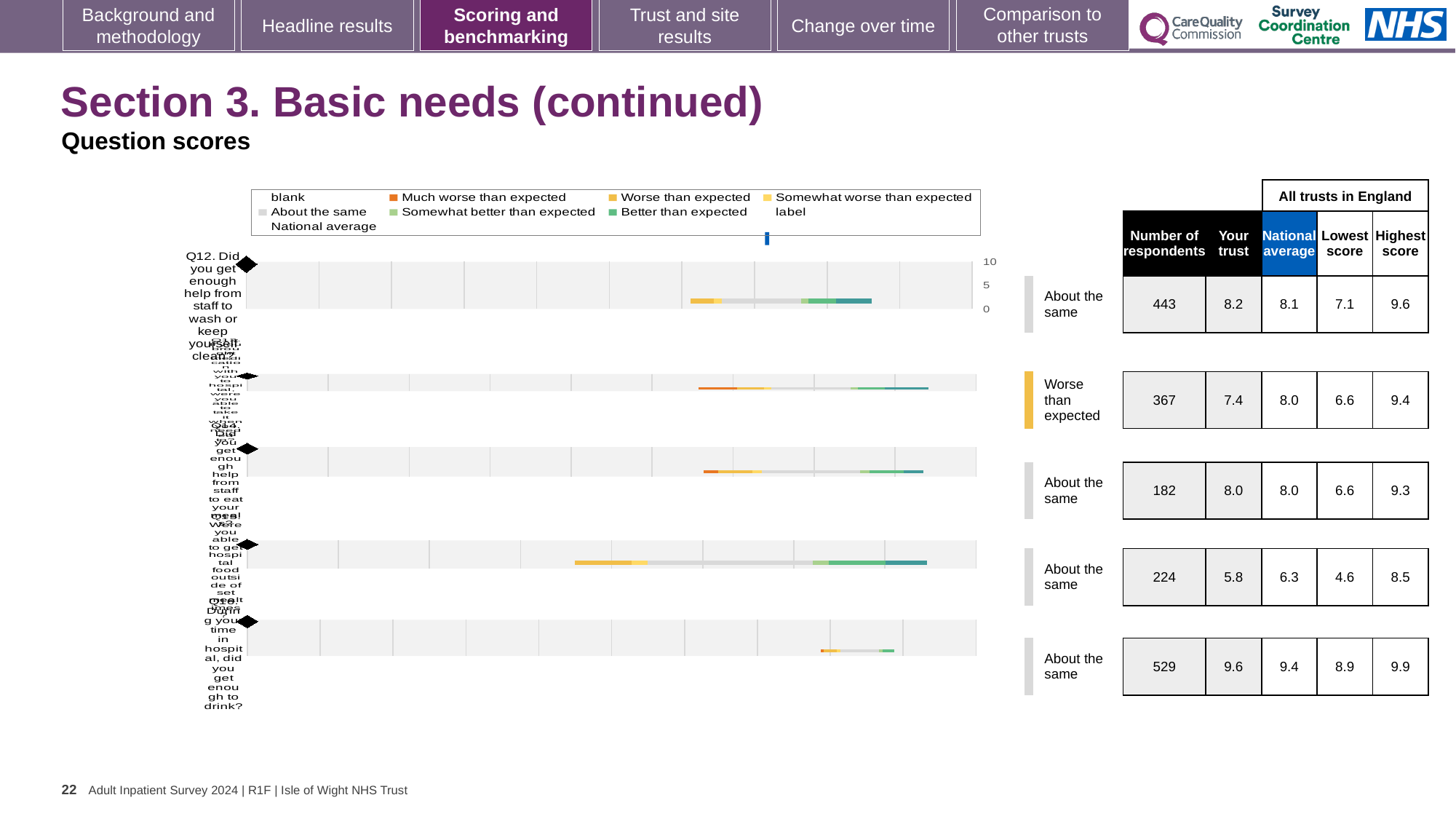
How many of the five rows are rated 'About the same'? 4 What is the highest score among all trusts in England for Q12 (Did you get enough help from staff to wash or keep yourself clean)? 9.6 How many question rows are plotted in the chart? 5 Which row has the highest 'Your trust' score? the fifth (bottom) row (9.6) For Q12 (Did you get enough help from staff to wash or keep yourself clean), which is larger: the 'Your trust' score or the national average? Your trust (8.2) Which row has the lowest 'Your trust' score? the fourth row (5.8) What is the 'Your trust' score for the row rated 'Worse than expected'? 7.4 What is the difference between the 'Your trust' score and the national average for Q12 (Did you get enough help from staff to wash or keep yourself clean)? 0.1 What is the national average score for Q12 (Did you get enough help from staff to wash or keep yourself clean)? 8.1 What is the 'Your trust' score for Q12 (Did you get enough help from staff to wash or keep yourself clean)? 8.2 What kind of chart is shown on the slide? bar chart How many respondents answered Q12 (Did you get enough help from staff to wash or keep yourself clean)? 443